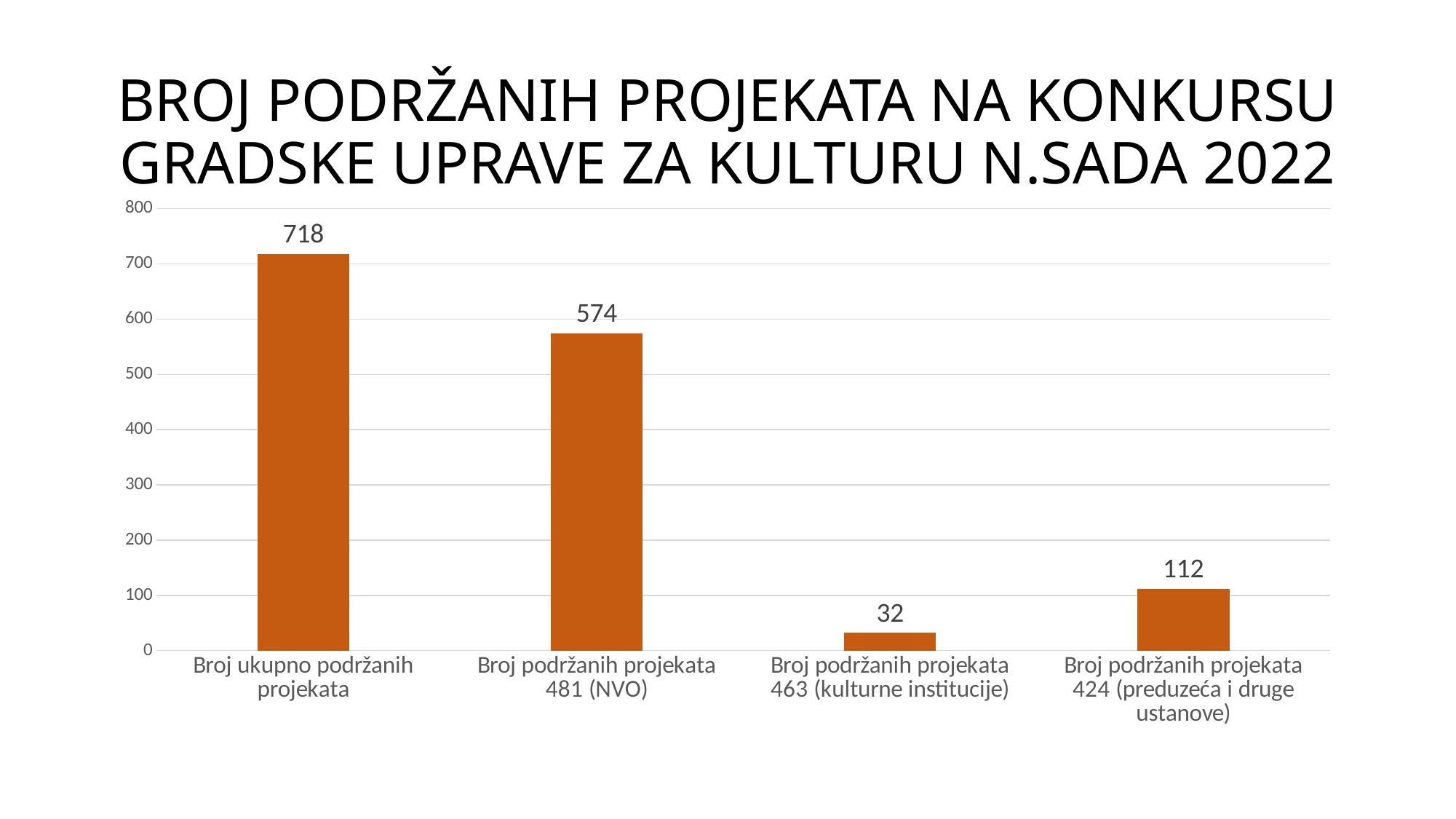
What is the difference between the values for 'Broj ukupno podržanih projekata' and 'Broj podržanih projekata 481 (NVO)'? 144 What is the value for 'Broj ukupno podržanih projekata'? 718 What kind of chart is shown on the slide? bar chart What is the value for 'Broj podržanih projekata 424 (preduzeća i druge ustanove)'? 112 Which category has the lowest value? Broj podržanih projekata 463 (kulturne institucije) What is the title of the slide? BROJ PODRŽANIH PROJEKATA NA KONKURSU GRADSKE UPRAVE ZA KULTURU N.SADA 2022 Is the value for 'Broj podržanih projekata 481 (NVO)' greater or less than 500? greater What is the value for 'Broj podržanih projekata 463 (kulturne institucije)'? 32 Which is larger: the value for 'Broj podržanih projekata 424 (preduzeća i druge ustanove)' or 'Broj podržanih projekata 463 (kulturne institucije)'? Broj podržanih projekata 424 (preduzeća i druge ustanove) How many categories are shown in the chart? 4 Which category has the highest value? Broj ukupno podržanih projekata What is the value for 'Broj podržanih projekata 481 (NVO)'? 574